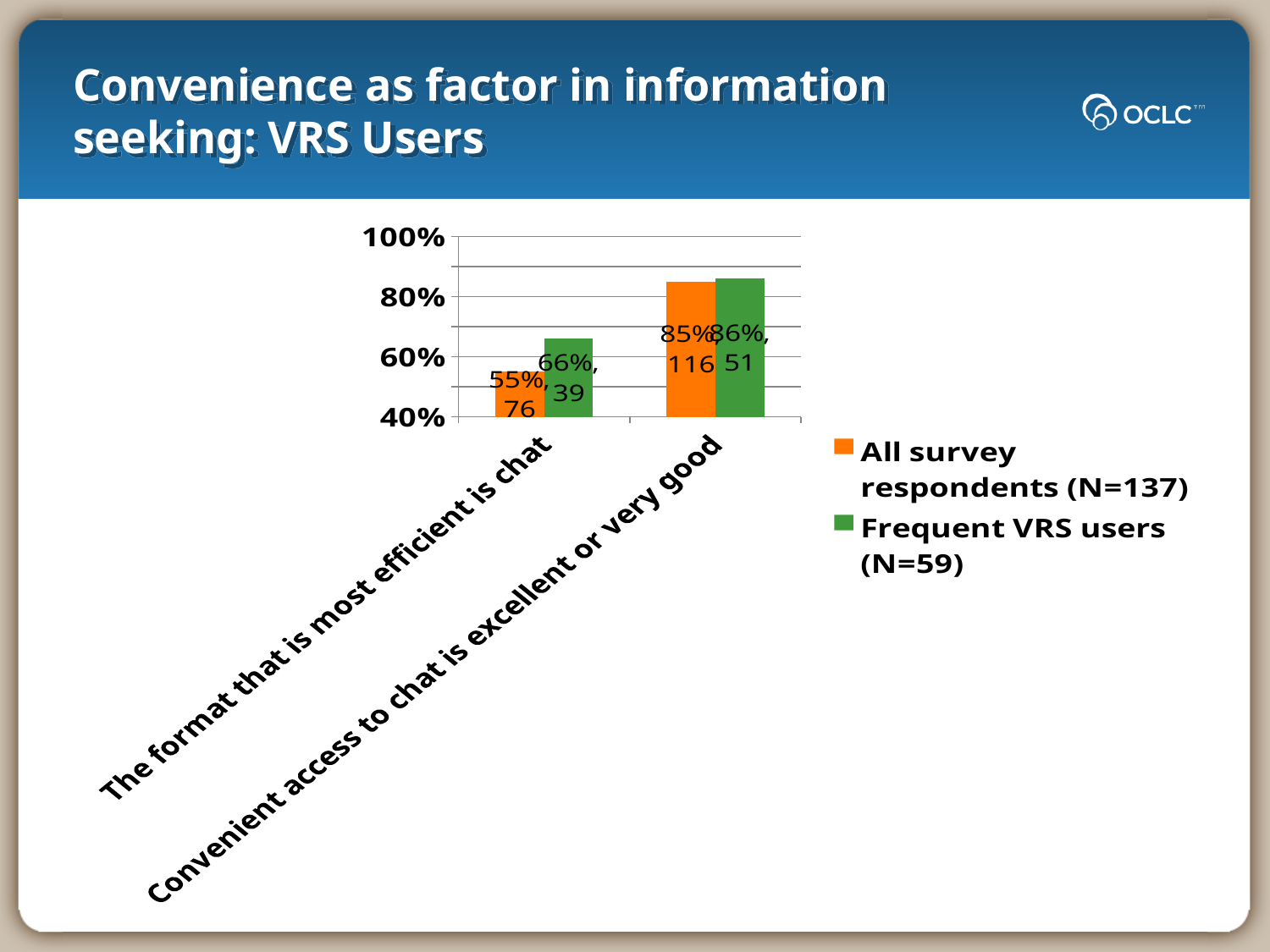
How many categories are shown on the x axis? 2 What percentage of all survey respondents said the format that is most efficient is chat? 55% What percentage of frequent VRS users said convenient access to chat is excellent or very good? 86% What is the sample size (N) given in the legend for frequent VRS users? 59 For 'The format that is most efficient is chat', which series has the larger value: all survey respondents or frequent VRS users? Frequent VRS users How many series does the legend list? 2 Which category has the highest value for all survey respondents? Convenient access to chat is excellent or very good What is the difference in percentage points between frequent VRS users and all survey respondents for 'The format that is most efficient is chat'? 11 How many all survey respondents said the format that is most efficient is chat, according to the data label? 76 What percentage of all survey respondents said convenient access to chat is excellent or very good? 85% What percentage of frequent VRS users said the format that is most efficient is chat? 66% What kind of chart is shown on the slide? bar chart